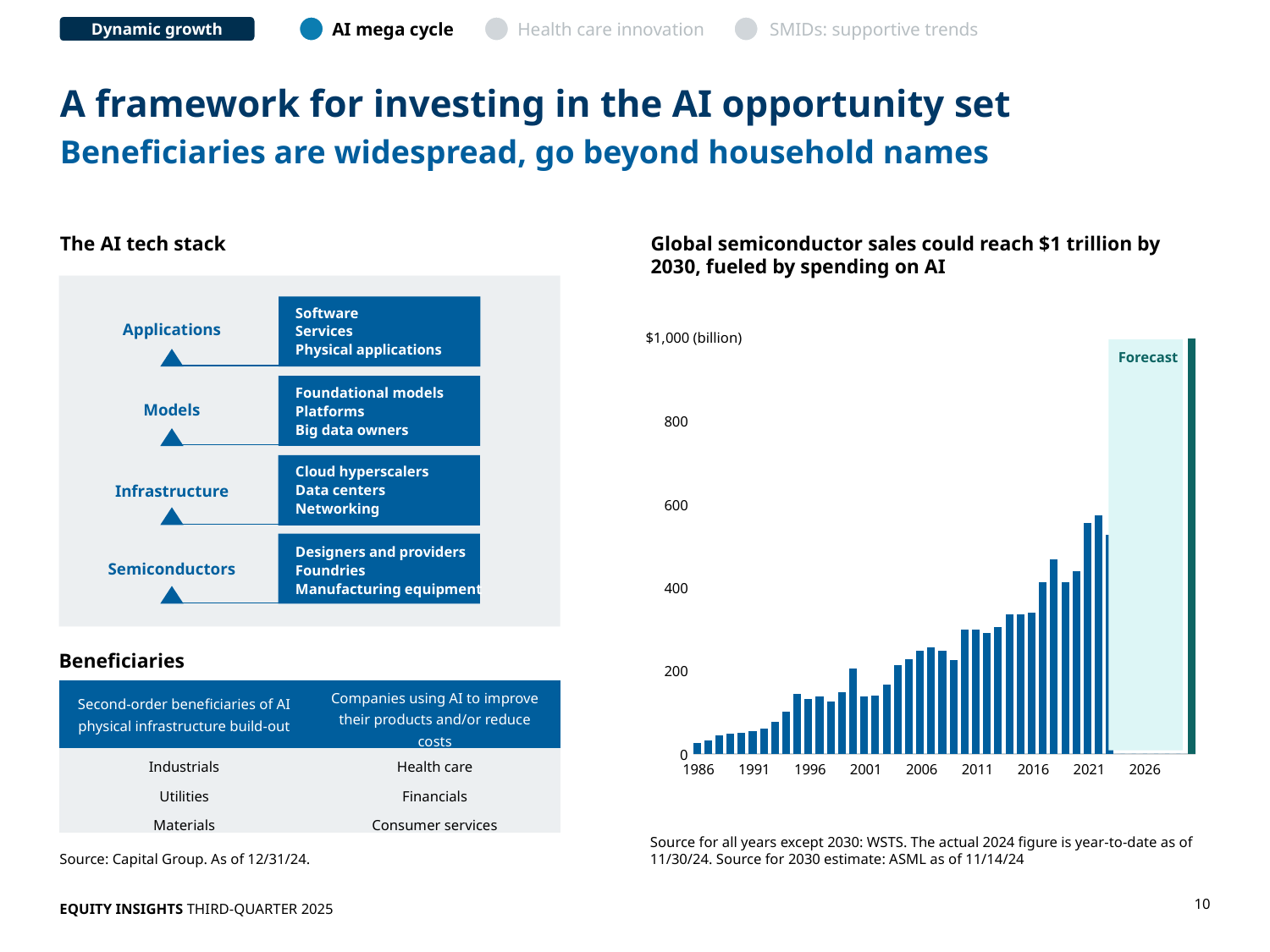
Is the value for 2021 in the semiconductor sales chart greater or less than 400? greater Is the value for 2016 in the semiconductor sales chart greater or less than 400? less Is the value for 1991 in the semiconductor sales chart greater or less than 200? less What kind of chart is used to show global semiconductor sales? Bar chart In the semiconductor sales chart, which is larger, the value for 2016 or the value for 2021? 2021 How many year labels are shown on the x axis of the semiconductor sales chart? 9 Do global semiconductor sales generally rise or fall from 1986 to 2021? Rise What is the title of the chart on the right side of the slide? Global semiconductor sales could reach $1 trillion by 2030, fueled by spending on AI Which year has the lowest bar in the semiconductor sales chart? 1986 What label appears in the shaded area at the right end of the semiconductor sales chart? Forecast